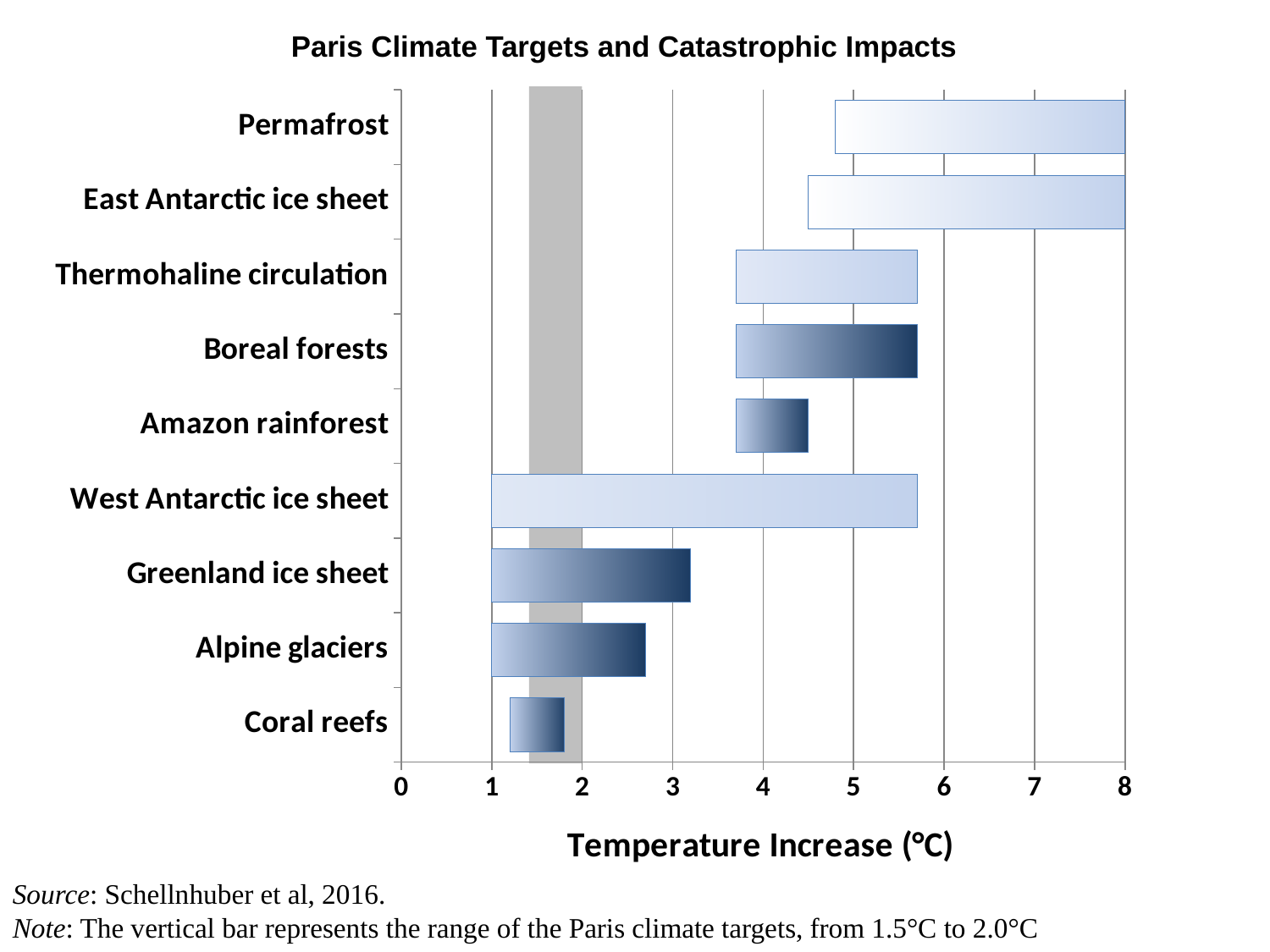
What is the title of the chart? Paris Climate Targets and Catastrophic Impacts Is the upper end of the Coral reefs bar greater or less than 2? less Is the lower end of the Thermohaline circulation bar greater or less than 4? less What kind of chart is shown on the slide? bar chart At what temperature increase does the Greenland ice sheet bar begin on the left? 1 Which category's bar spans the widest range of temperature increase? West Antarctic ice sheet Which bar extends further to the right, Greenland ice sheet or Alpine glaciers? Greenland ice sheet At what temperature increase does the Permafrost bar end on the right? 8 Which category has the bar with the lowest upper end? Coral reefs Is the upper end of the Greenland ice sheet bar greater or less than 3? greater How many categories (impacts) are listed on the vertical axis of the chart? 9 What is the label of the horizontal axis? Temperature Increase (°C)